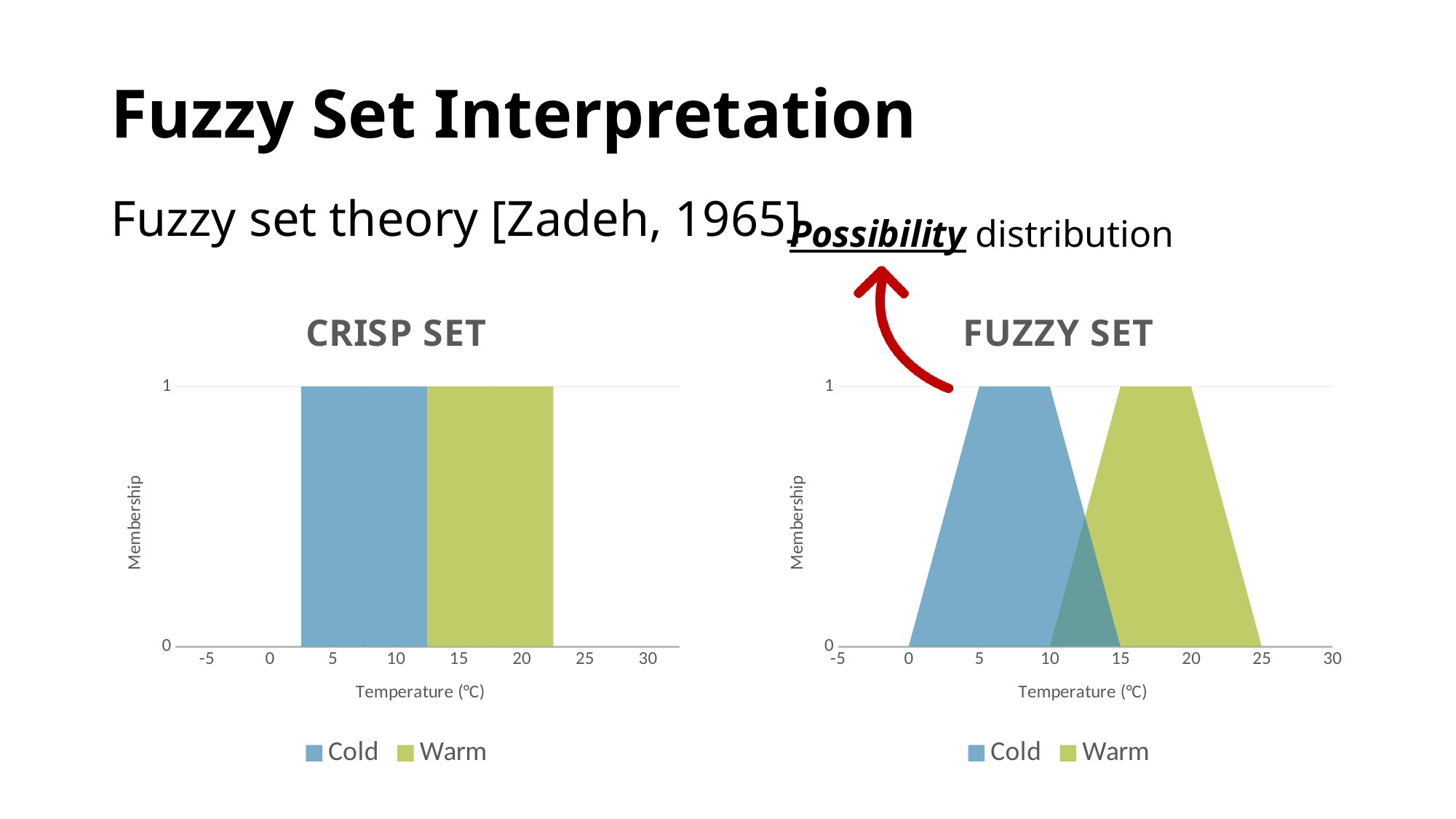
In the CRISP SET chart, what is the Membership value of Warm at a temperature of 20 °C? 1 In the CRISP SET chart, how many series does the legend list? 2 In the FUZZY SET chart, what is the Membership value of Warm at a temperature of 25 °C? 0 In the FUZZY SET chart, what is the Membership value of Cold at a temperature of 0 °C? 0 What is the title of the chart on the left? CRISP SET In the CRISP SET chart, what is the Membership value of Cold at a temperature of 5 °C? 1 In the FUZZY SET chart, what are the series listed in the legend? Cold, Warm How many charts are shown on the slide? 2 What is the title of the chart on the right? FUZZY SET What kind of chart is the FUZZY SET chart? Area chart In the CRISP SET chart, what is the Membership value of Cold at a temperature of 0 °C? 0 In the FUZZY SET chart, does the Membership of Cold rise or fall as temperature increases from 10 °C to 15 °C? Fall